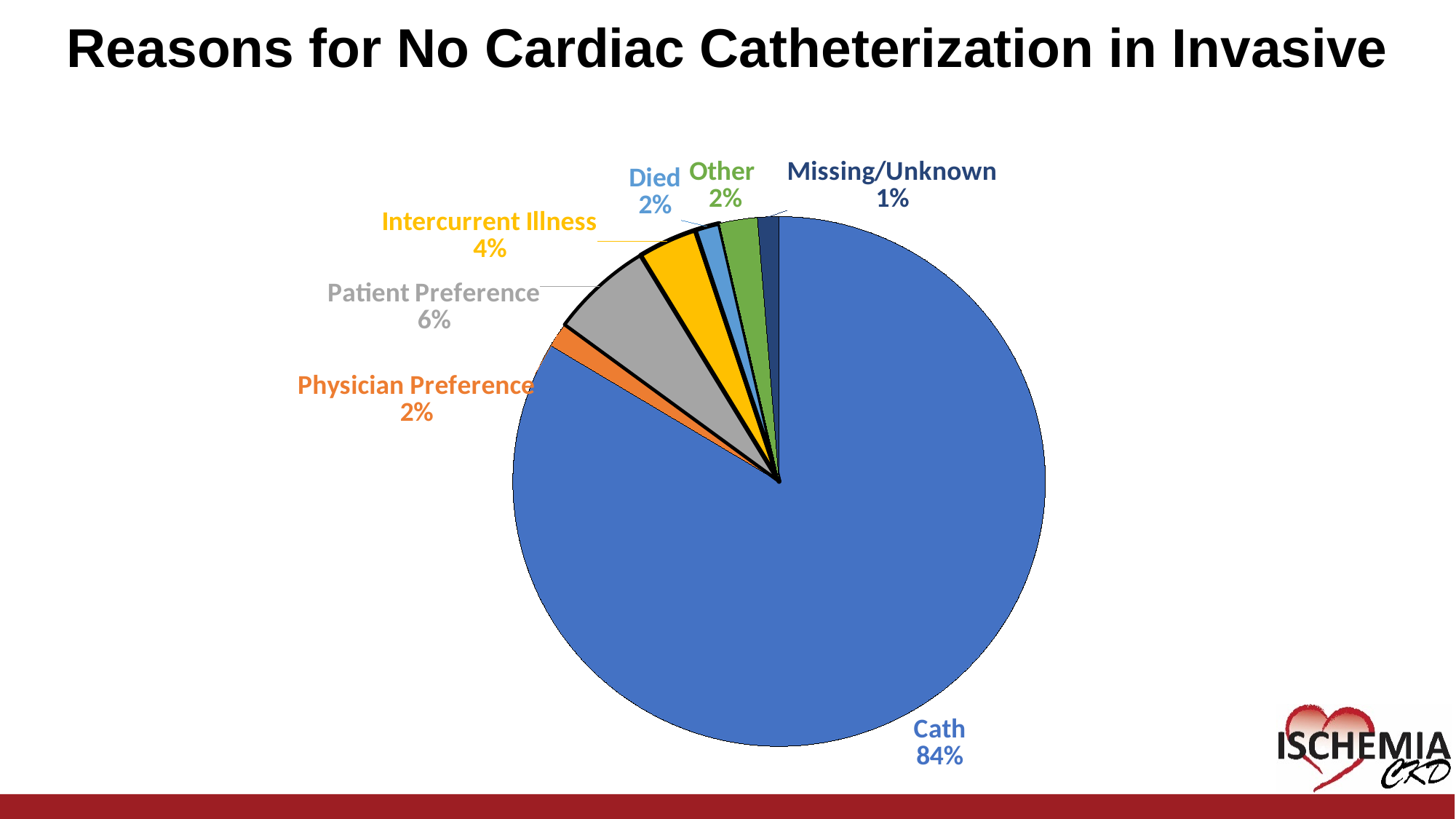
Which category has the largest slice? Cath What share of the pie does Cath represent? 84% What kind of chart is shown on the slide? pie chart Which category has the smallest slice? Missing/Unknown What is the value for Missing/Unknown? 1% Which is larger, Patient Preference or Intercurrent Illness? Patient Preference What is the value for Intercurrent Illness? 4% What is the difference between the Patient Preference and Intercurrent Illness shares? 2% What is the value for Physician Preference? 2% What is the value for Patient Preference? 6% How many categories are shown in the pie chart? 7 What is the title of the slide? Reasons for No Cardiac Catheterization in Invasive